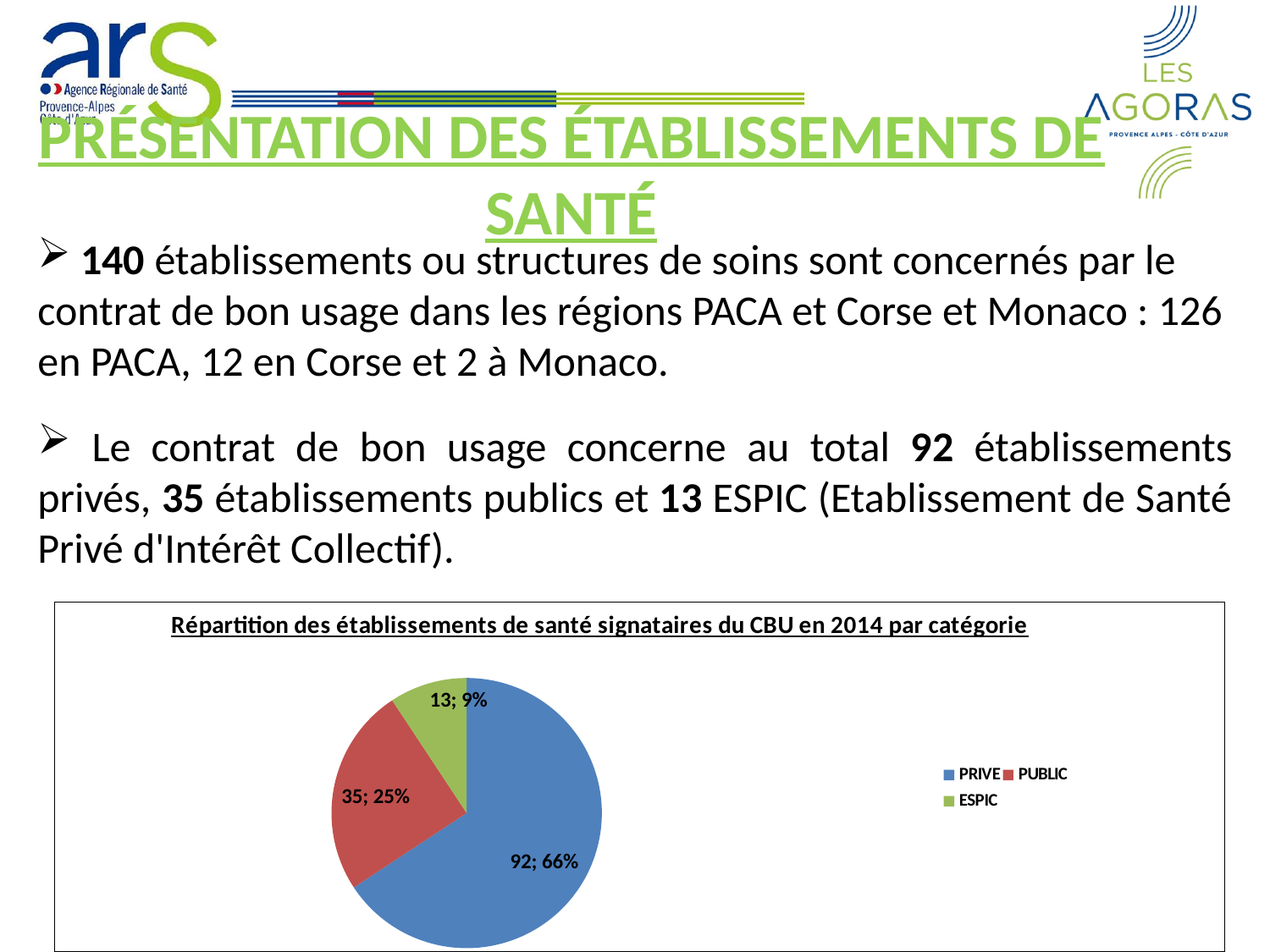
What is the value for PRIVE? 92 What kind of chart is shown on the slide? pie chart What is the value for PUBLIC? 35 How many entries does the legend list? 3 Which category has the largest slice? PRIVE Which category has the smallest slice? ESPIC What is the value for ESPIC? 13 What is the title of the chart? Répartition des établissements de santé signataires du CBU en 2014 par catégorie How many categories does the pie chart show? 3 What is the difference between the PRIVE and PUBLIC values? 57 What share of the pie does PRIVE represent? 66% What share of the pie does ESPIC represent? 9%